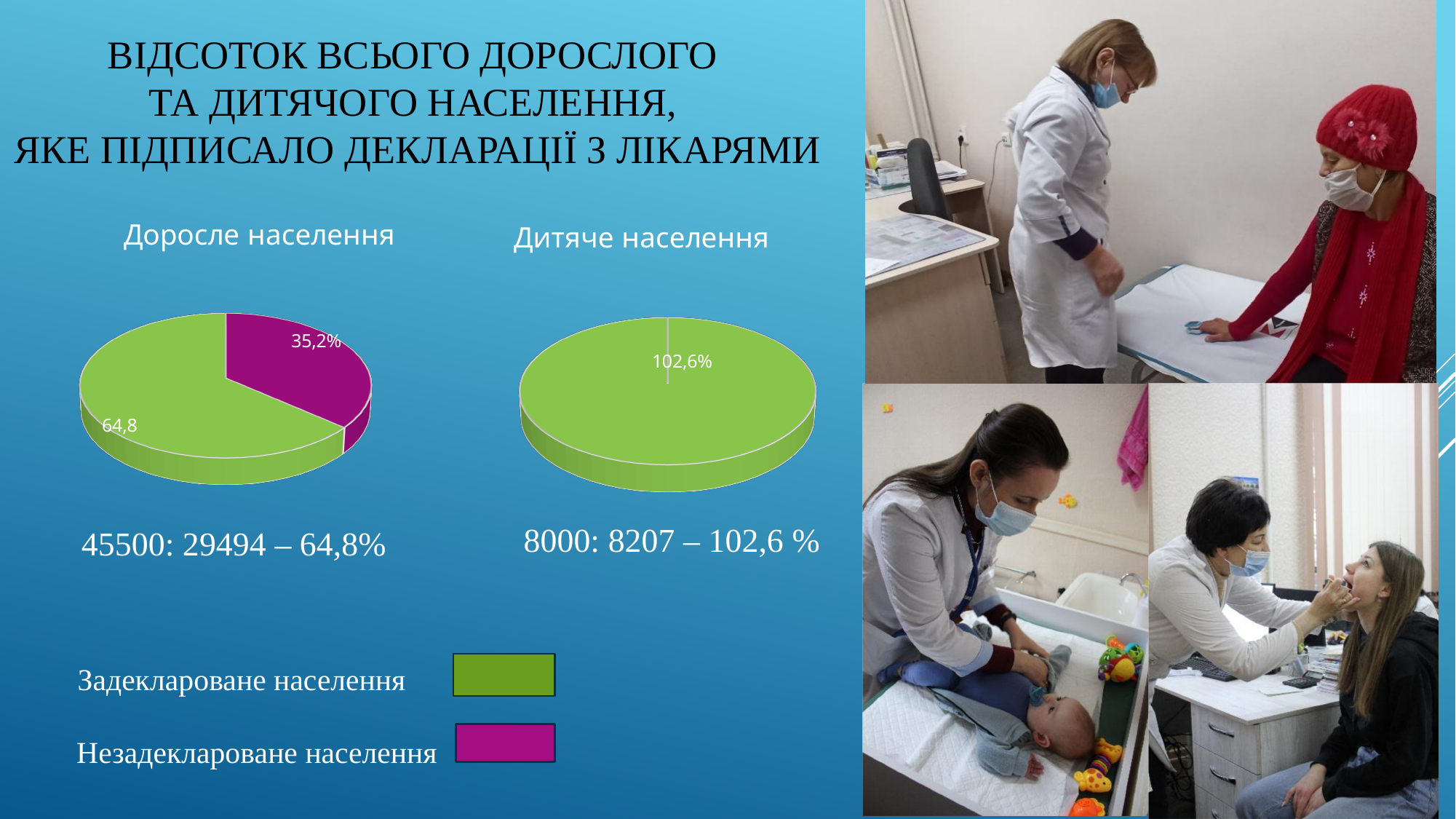
How many slices does the "Дитяче населення" pie chart have? 1 In the "Доросле населення" pie chart, what share of the pie does the Незадеклароване населення slice represent? 35,2% In the "Доросле населення" pie chart, what is the difference between the Задеклароване населення value (64,8) and the Незадеклароване населення value (35,2)? 29,6 In the "Доросле населення" pie chart, which category has the smallest slice? Незадеклароване населення In the "Доросле населення" pie chart, which slice is larger: Задеклароване населення or Незадеклароване населення? Задеклароване населення In the "Дитяче населення" pie chart, what value is printed on the chart? 102,6% What is the title of the pie chart on the left? Доросле населення In the "Доросле населення" pie chart, what value is shown for the magenta (Незадеклароване населення) slice? 35,2% What kind of chart is the "Доросле населення" chart? Pie chart How many slices does the "Доросле населення" pie chart have? 2 In the "Доросле населення" pie chart, what value is shown for the green (Задеклароване населення) slice? 64,8 According to the legend, what colour represents Незадеклароване населення? Magenta (purple)